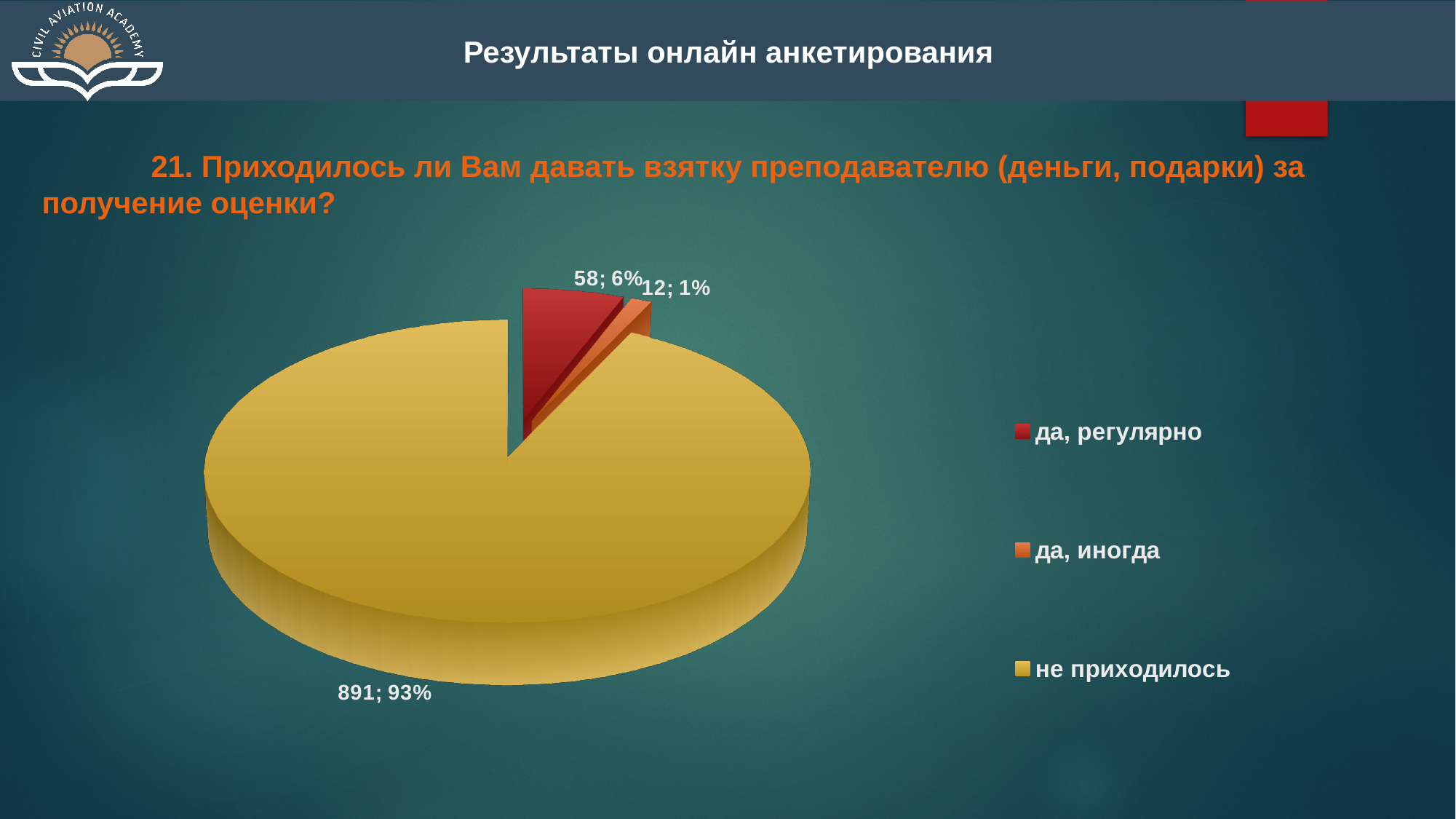
What is the difference in the number of respondents between "не приходилось" and "да, регулярно"? 833 What colour is the "не приходилось" slice in the pie chart? yellow What is the difference in the number of respondents between "да, регулярно" and "да, иногда"? 46 How many answer options (slices) does the pie chart show? 3 What percentage share does the "да, регулярно" slice have? 6% Which answer option has the largest slice of the pie? не приходилось How many respondents answered "да, иногда"? 12 How many respondents answered "не приходилось"? 891 What percentage share does the "не приходилось" slice have? 93% Which answer option has the smallest slice of the pie? да, иногда Which has more respondents, "да, регулярно" or "да, иногда"? да, регулярно What kind of chart is shown on the slide? pie chart